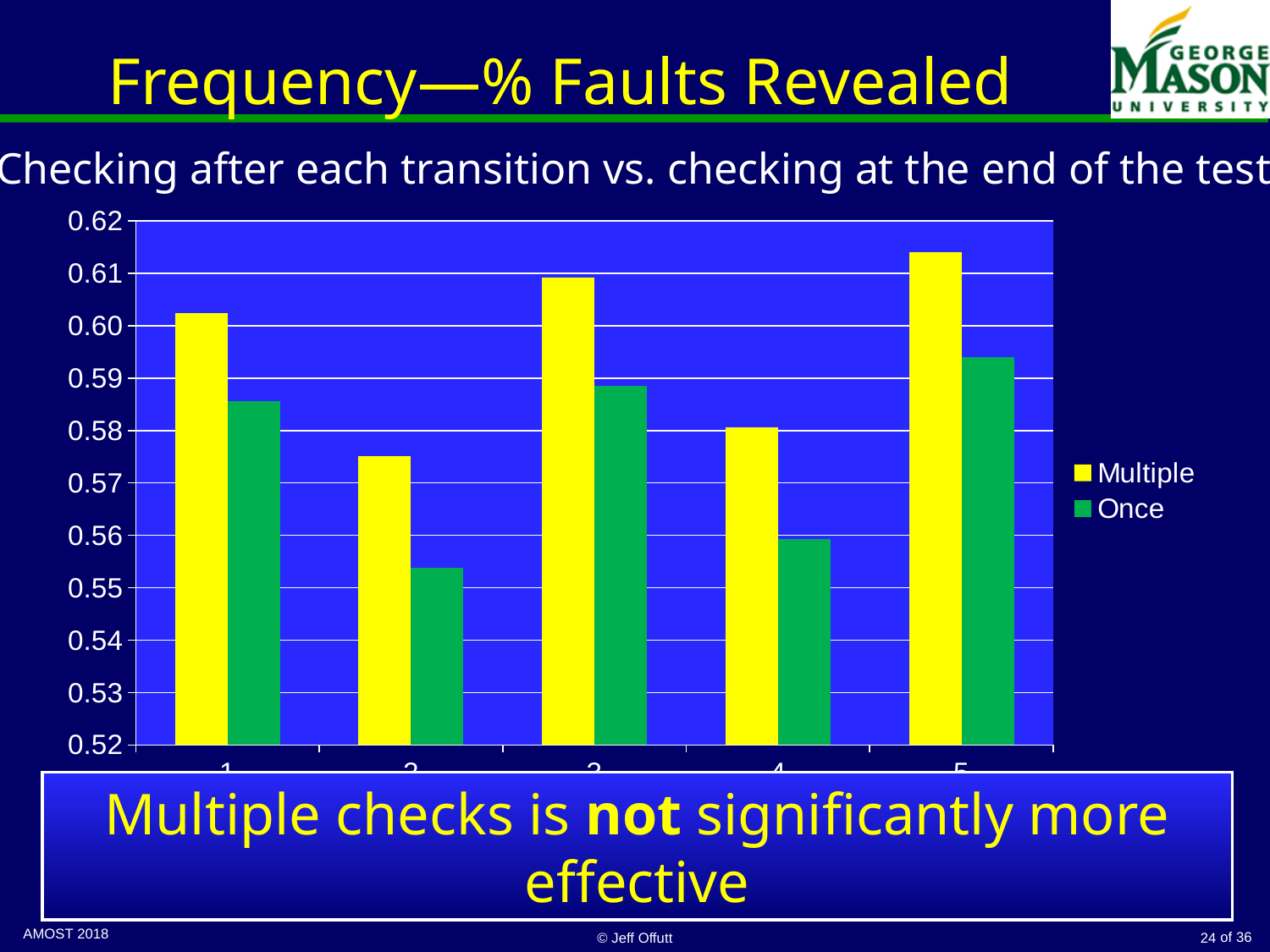
Which category has the lowest Once bar? 2 In category 1, which series has the larger value, Multiple or Once? Multiple How many series does the legend list? 2 Is the Once value for category 2 greater or less than 0.57? less Which colour represents the Multiple series? yellow Is the Multiple value for category 1 greater or less than 0.59? greater What kind of chart is shown on the slide? bar chart Which category has the highest Multiple bar? 5 What are the two series named in the legend? Multiple and Once Which category has the lowest Multiple bar? 2 Which category has the highest Once bar? 5 How many category groups of bars are plotted along the x axis? 5